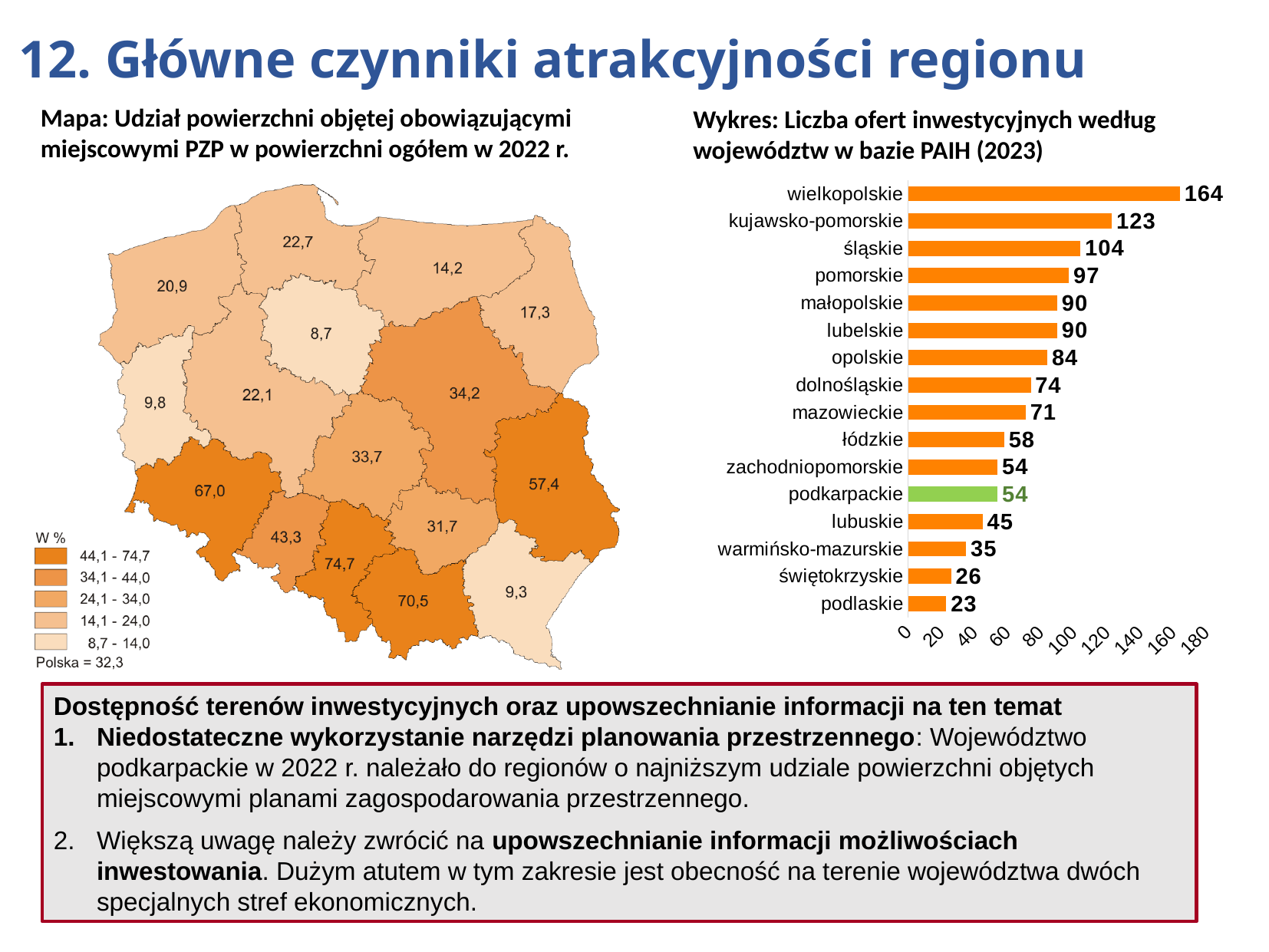
In the bar chart on the right, what is the value for śląskie? 104 In the bar chart on the right, what is the highest value shown on the horizontal axis? 180 What type of chart is shown on the right side of the slide? bar chart In the bar chart on the right, what is the difference between the values for wielkopolskie and kujawsko-pomorskie? 41 In the bar chart on the right, how many województwa (categories) are shown? 16 In the bar chart on the right, what is the difference between the values for podkarpackie and podlaskie? 31 In the bar chart on the right, what is the value for podkarpackie? 54 In the bar chart on the right, which województwo has the highest number of investment offers? wielkopolskie In the bar chart 'Liczba ofert inwestycyjnych według województw w bazie PAIH (2023)', what is the value for wielkopolskie? 164 In the bar chart on the right, which województwo has the lowest number of investment offers? podlaskie In the bar chart on the right, which is larger: the value for pomorskie or the value for opolskie? pomorskie In the bar chart on the right, which bar is highlighted in green instead of orange? podkarpackie